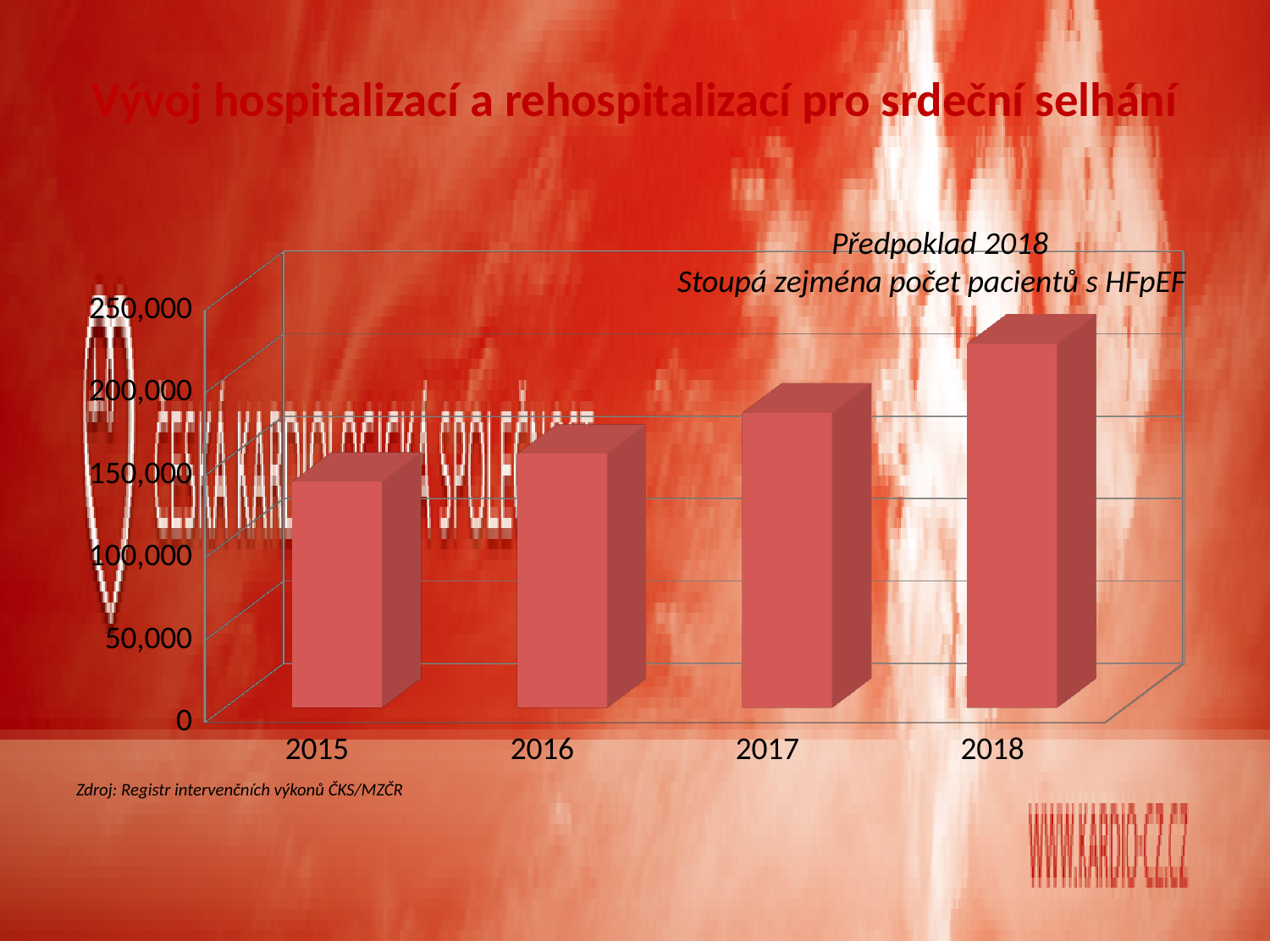
How many years are shown on the x axis of the chart? 4 Is the value for 2015 greater or less than 200,000? less Is the value for 2018 greater or less than 200,000? greater Is the value for 2016 greater or less than 100,000? greater What is the title of the slide containing the chart? Vývoj hospitalizací a rehospitalizací pro srdeční selhání What kind of chart is shown on the slide? bar chart Which year has the highest bar in the chart? 2018 Do the values rise or fall from 2015 to 2018? rise Which year has the larger value, 2015 or 2018? 2018 Which year has the larger value, 2016 or 2017? 2017 Which year has the lowest bar in the chart? 2015